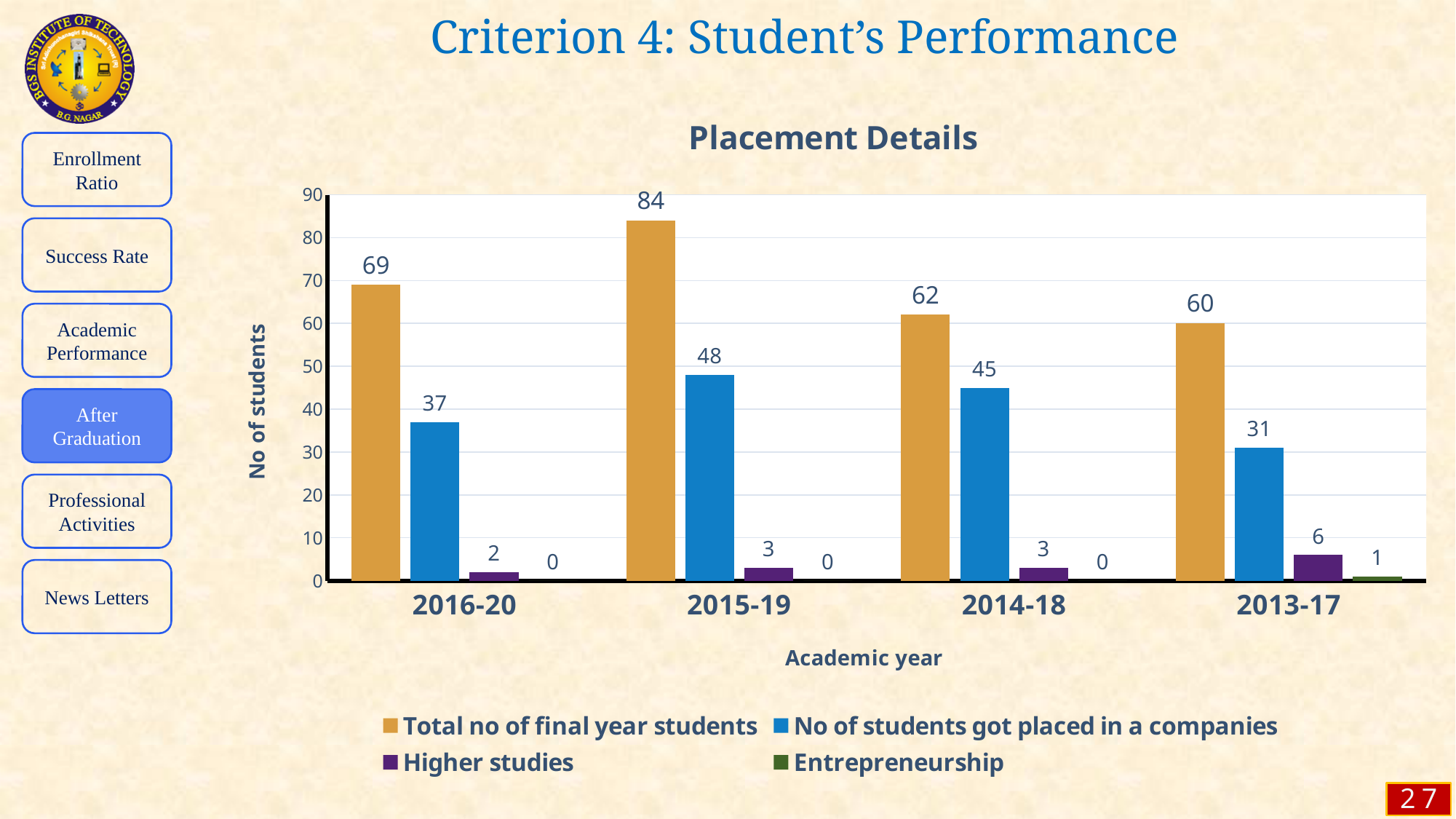
What is the total number of final year students for 2015-19? 84 Which is larger: the number of students placed in companies in 2015-19 or in 2016-20? 2015-19 How many series does the legend list? 4 Which academic year has the highest total number of final year students? 2015-19 What is the Entrepreneurship value for 2014-18? 0 What is the Higher studies value for 2013-17? 6 What is the difference between the total number of final year students and the number placed in companies in 2014-18? 17 What kind of chart is shown on the slide? Bar chart What is the title of the chart? Placement Details How many students got placed in companies in 2016-20? 37 Which academic year has the lowest number of students placed in companies? 2013-17 How many academic years are shown on the x axis? 4